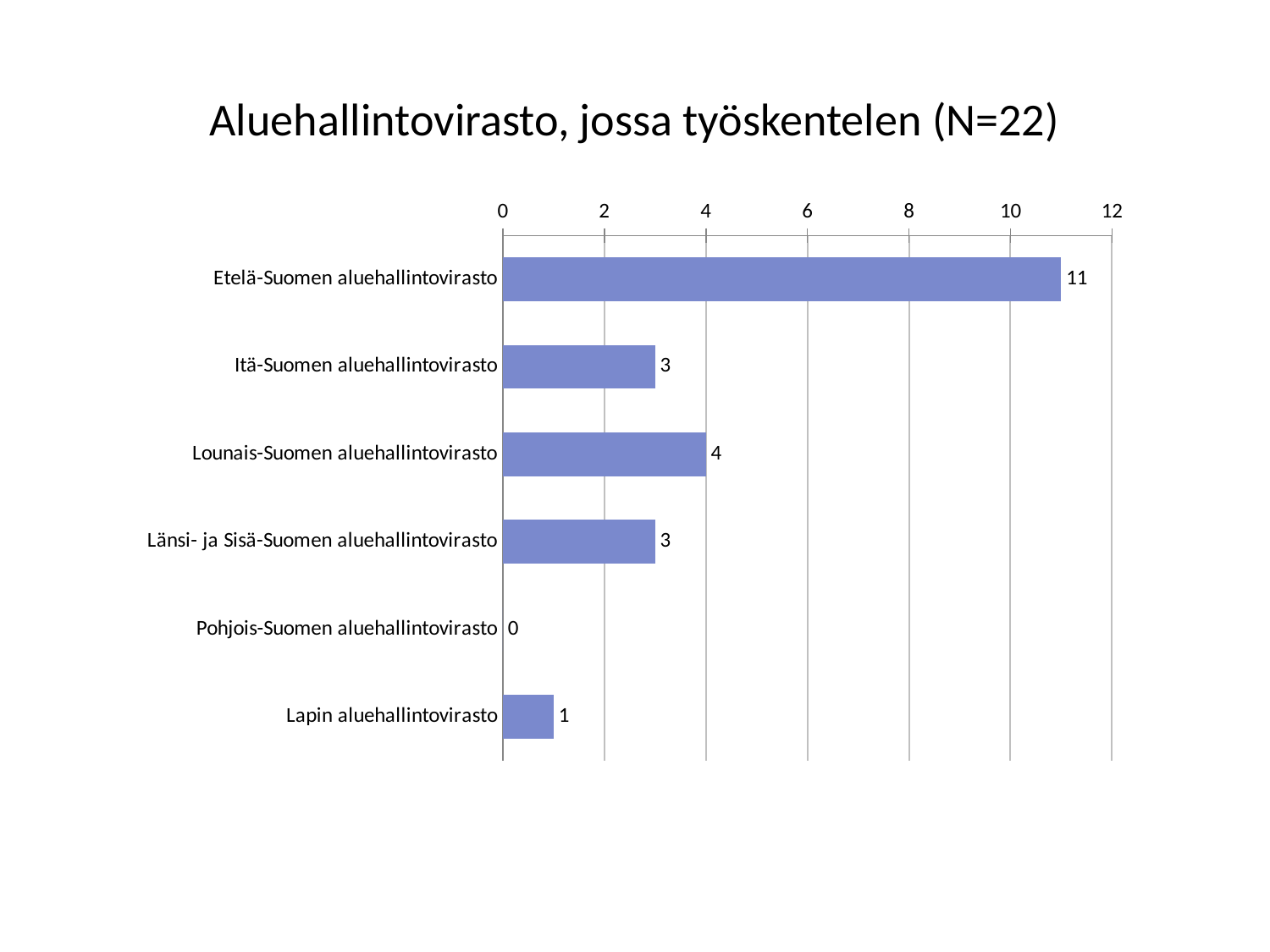
What is the difference between the values for Etelä-Suomen aluehallintovirasto and Lounais-Suomen aluehallintovirasto? 7 What kind of chart is shown on the slide? bar chart What is the title of the chart? Aluehallintovirasto, jossa työskentelen (N=22) How many categories are shown in the chart? 6 What is the value for Pohjois-Suomen aluehallintovirasto? 0 Is the value for Etelä-Suomen aluehallintovirasto greater or less than 10? greater What is the value for Etelä-Suomen aluehallintovirasto? 11 What is the value for Lounais-Suomen aluehallintovirasto? 4 Which is larger, the value for Lounais-Suomen aluehallintovirasto or Itä-Suomen aluehallintovirasto? Lounais-Suomen aluehallintovirasto What is the value for Lapin aluehallintovirasto? 1 Which category has the lowest value? Pohjois-Suomen aluehallintovirasto Which category has the highest value? Etelä-Suomen aluehallintovirasto